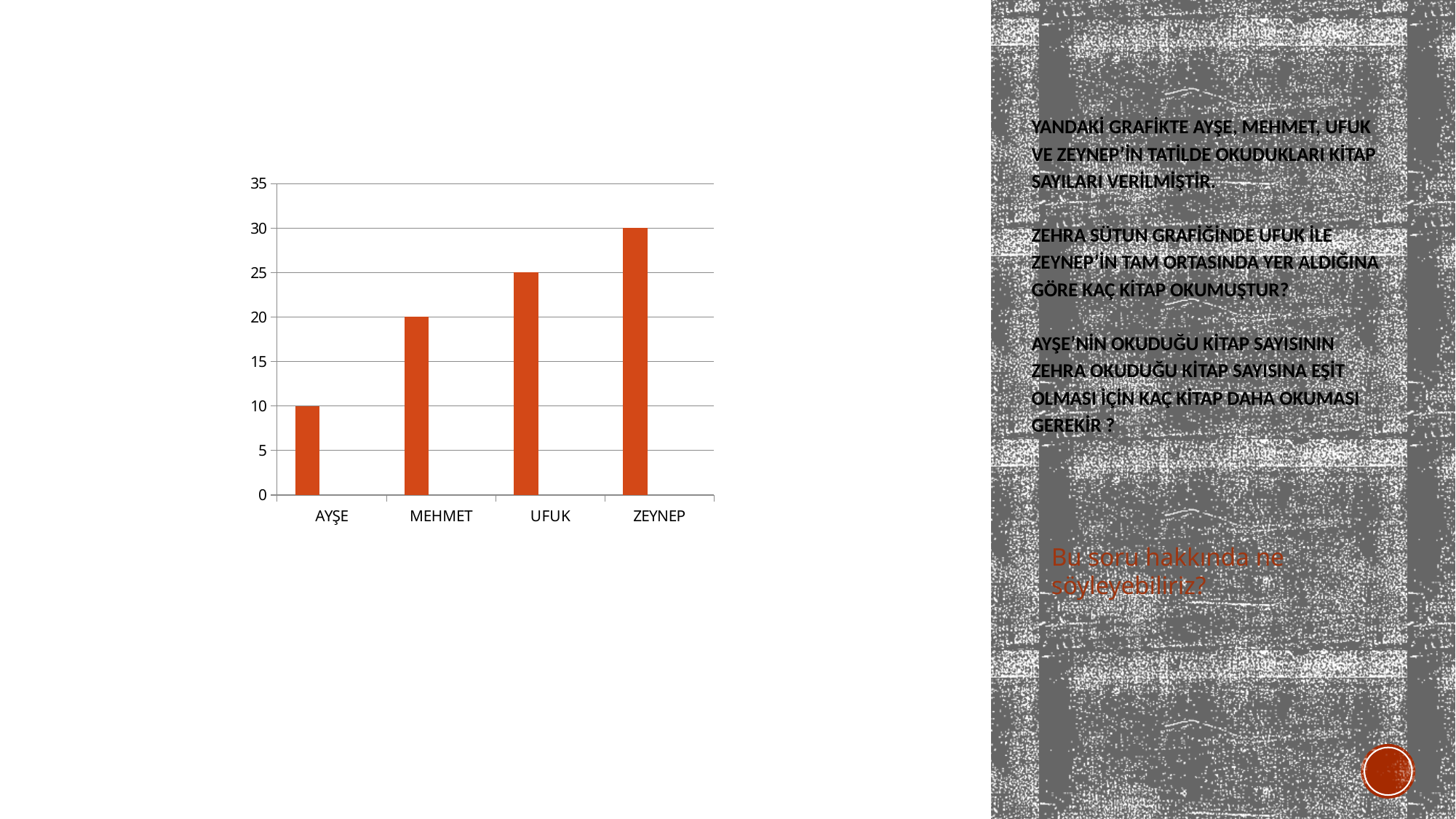
What kind of chart is shown on the slide? bar chart What is the value for AYŞE? 10 What is the highest value shown on the vertical axis of the chart? 35 What is the value for UFUK? 25 Which category has the highest value? ZEYNEP What is the value for ZEYNEP? 30 Do the values rise or fall from AYŞE to ZEYNEP along the x axis? rise Which category has the lowest value? AYŞE What is the difference between the values for ZEYNEP and AYŞE? 20 How many categories are shown on the x axis of the chart? 4 Which is larger, the value for MEHMET or the value for UFUK? UFUK What is the value for MEHMET? 20